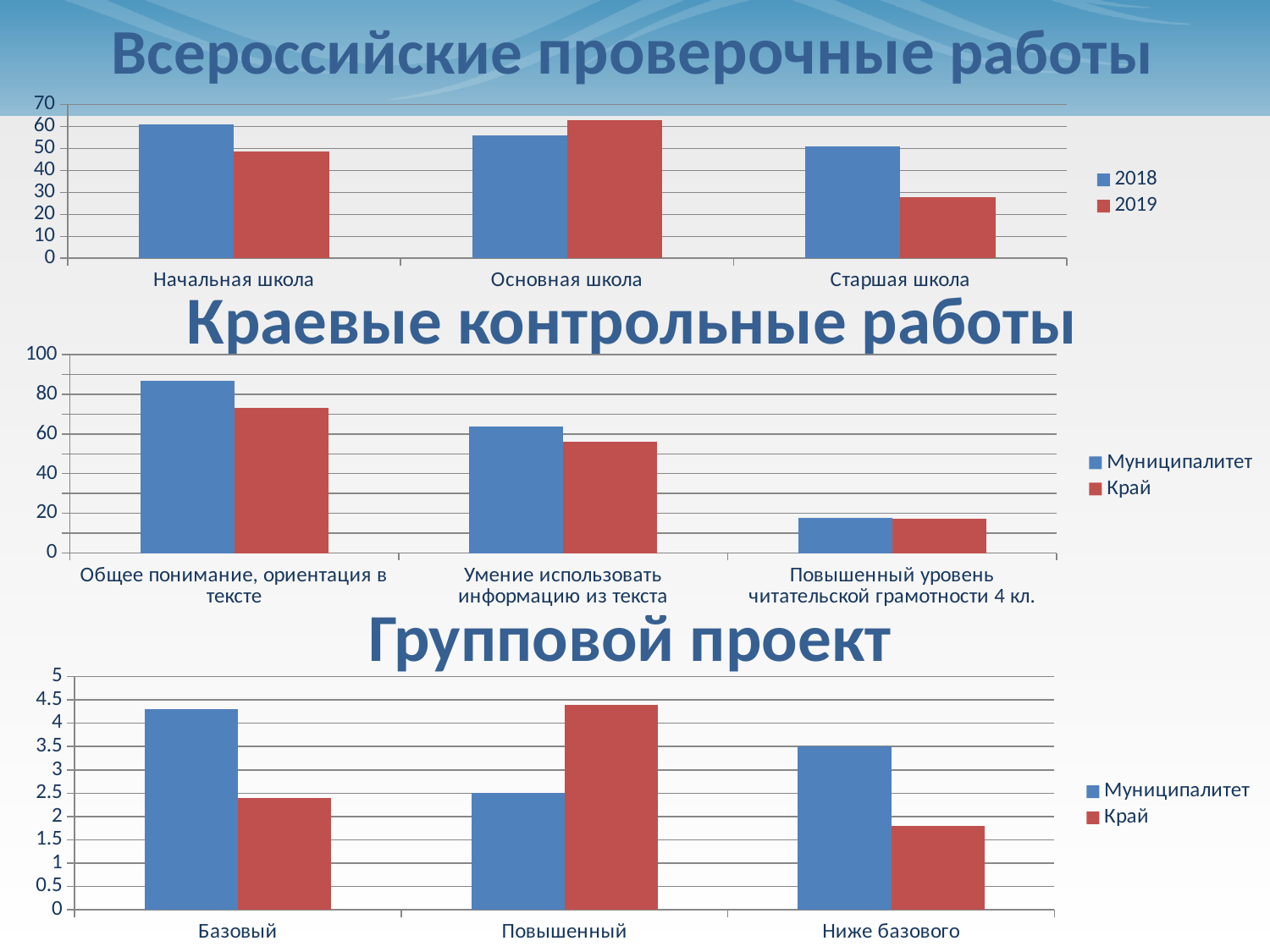
In the chart titled "Краевые контрольные работы", how many categories are shown on the x axis? 3 In the chart titled "Всероссийские проверочные работы", is the 2018 value for Начальная школа greater or less than 50? greater In the chart titled "Групповой проект", which category has the highest value for Край? Повышенный In the chart titled "Групповой проект", is the Муниципалитет value for Базовый greater or less than 4? greater In the chart titled "Краевые контрольные работы", which category has the highest value for Муниципалитет? Общее понимание, ориентация в тексте In the chart titled "Краевые контрольные работы", do the Муниципалитет values rise or fall from left to right along the x axis? fall In the chart titled "Краевые контрольные работы", is the Край value for Общее понимание, ориентация в тексте greater or less than 60? greater In the chart titled "Всероссийские проверочные работы", how many series does the legend list? 2 In the chart titled "Всероссийские проверочные работы", for Основная школа, which series has the larger value, 2018 or 2019? 2019 In the chart titled "Всероссийские проверочные работы", which category has the lowest value for 2019? Старшая школа What kind of chart is the one titled "Групповой проект"? bar chart